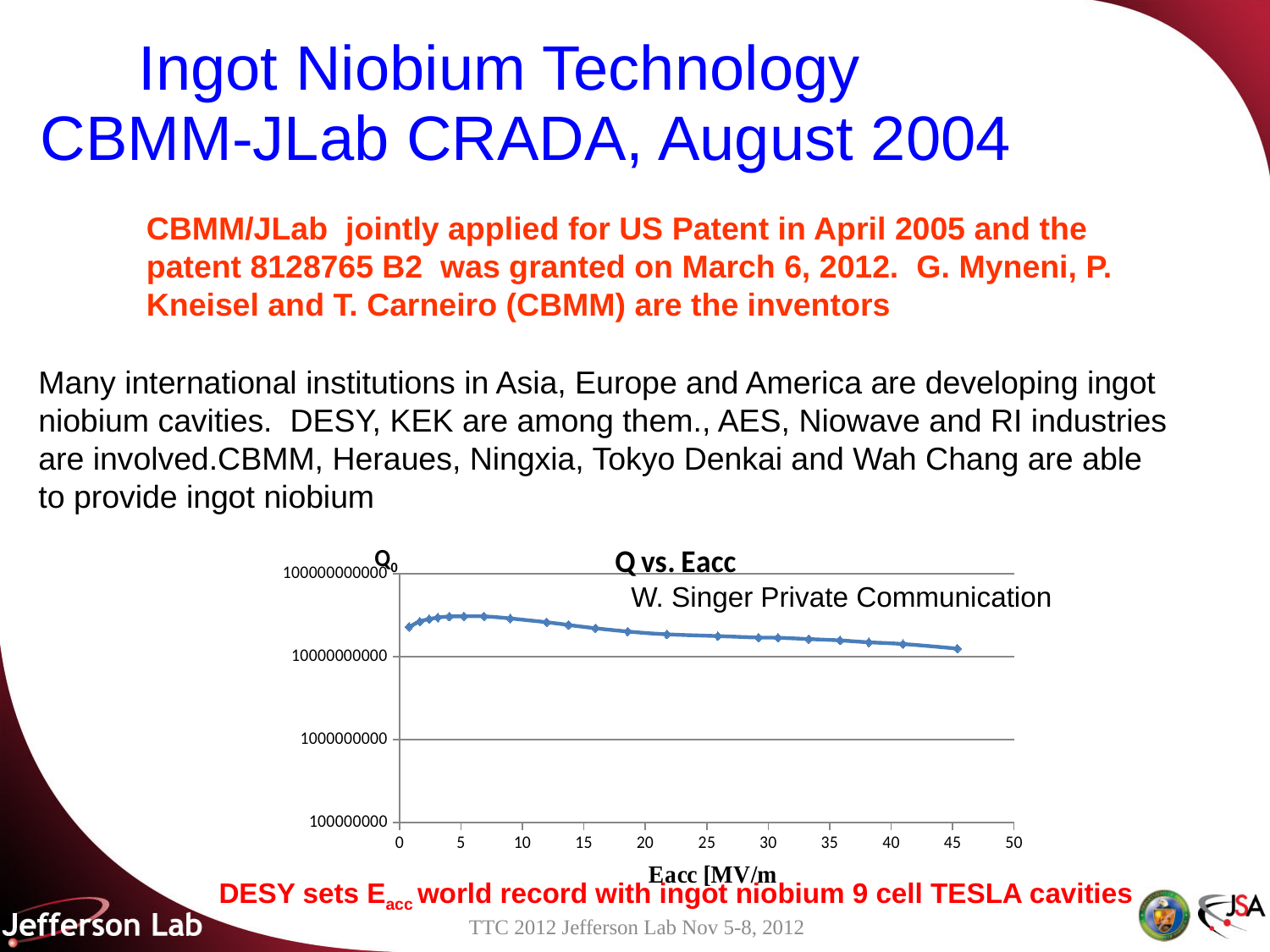
In the "Q vs. Eacc" chart, does the plotted Q value rise or fall as Eacc increases from 10 to 45 MV/m? fall What text annotation is printed inside the plot area of the "Q vs. Eacc" chart? W. Singer Private Communication In the "Q vs. Eacc" chart, is the Q value at Eacc = 5 greater or less than 10000000000? greater In the "Q vs. Eacc" chart, which has the higher Q value: Eacc = 5 or Eacc = 40? Eacc = 5 What is the title of the chart on the slide? Q vs. Eacc In the "Q vs. Eacc" chart, is the Q value at Eacc = 5 greater or less than 100000000000? less In the "Q vs. Eacc" chart, is the Q value at Eacc = 30 greater or less than 10000000000? greater In the "Q vs. Eacc" chart, which has the higher Q value: Eacc = 10 or Eacc = 45? Eacc = 10 What kind of chart is the "Q vs. Eacc" chart? line chart